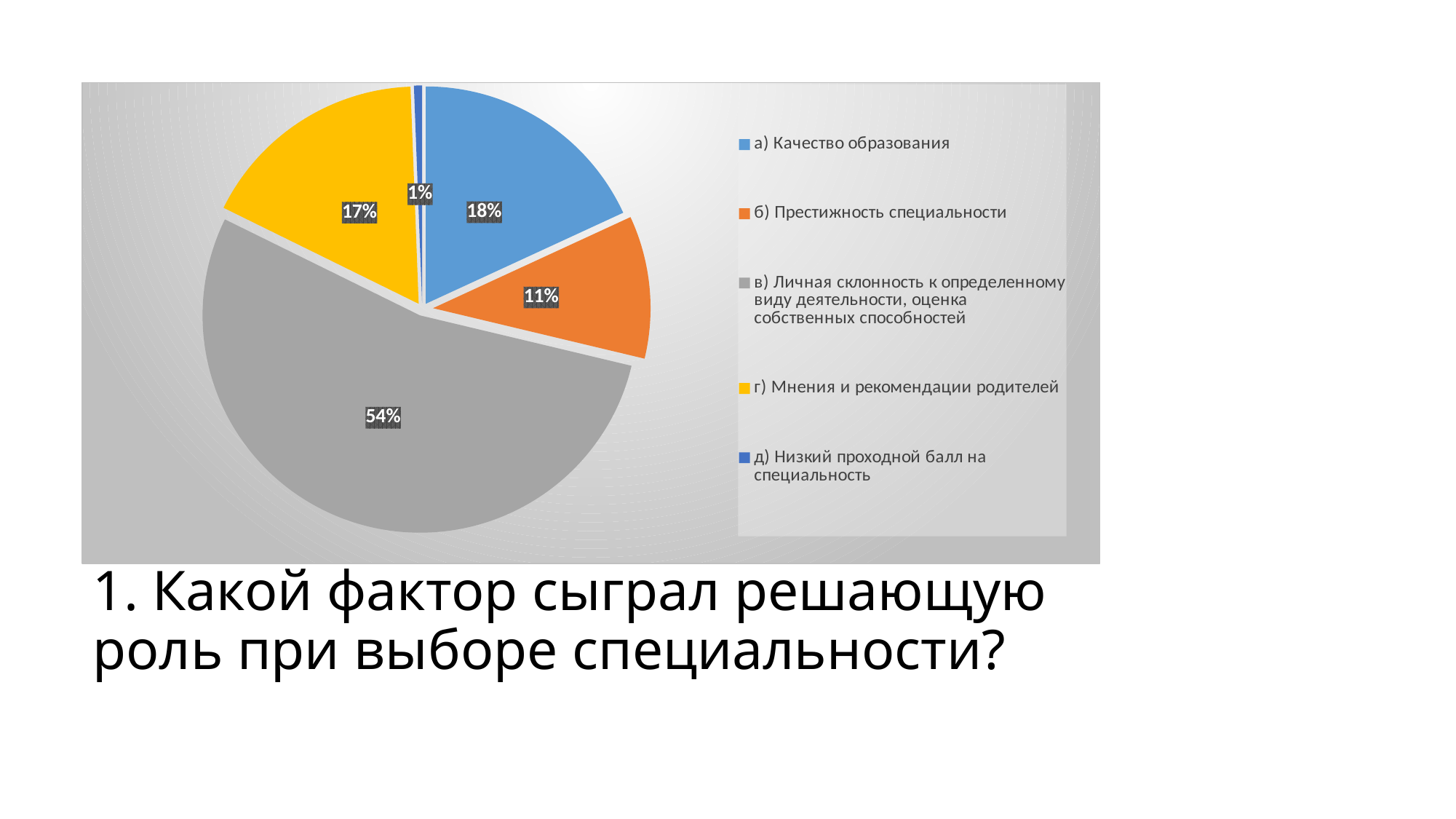
What share of the pie does "г) Мнения и рекомендации родителей" have? 17% What kind of chart is shown on the slide? Pie chart What share of the pie does "д) Низкий проходной балл на специальность" have? 1% Which category has the largest slice of the pie? в) Личная склонность к определенному виду деятельности, оценка собственных способностей What colour is the slice for "г) Мнения и рекомендации родителей"? Yellow Which is larger: the share for "а) Качество образования" or for "г) Мнения и рекомендации родителей"? а) Качество образования Which category has the smallest slice of the pie? д) Низкий проходной балл на специальность What is the difference between the shares of "а) Качество образования" and "б) Престижность специальности"? 7% What share of the pie does "б) Престижность специальности" have? 11% How many categories does the pie chart have? 5